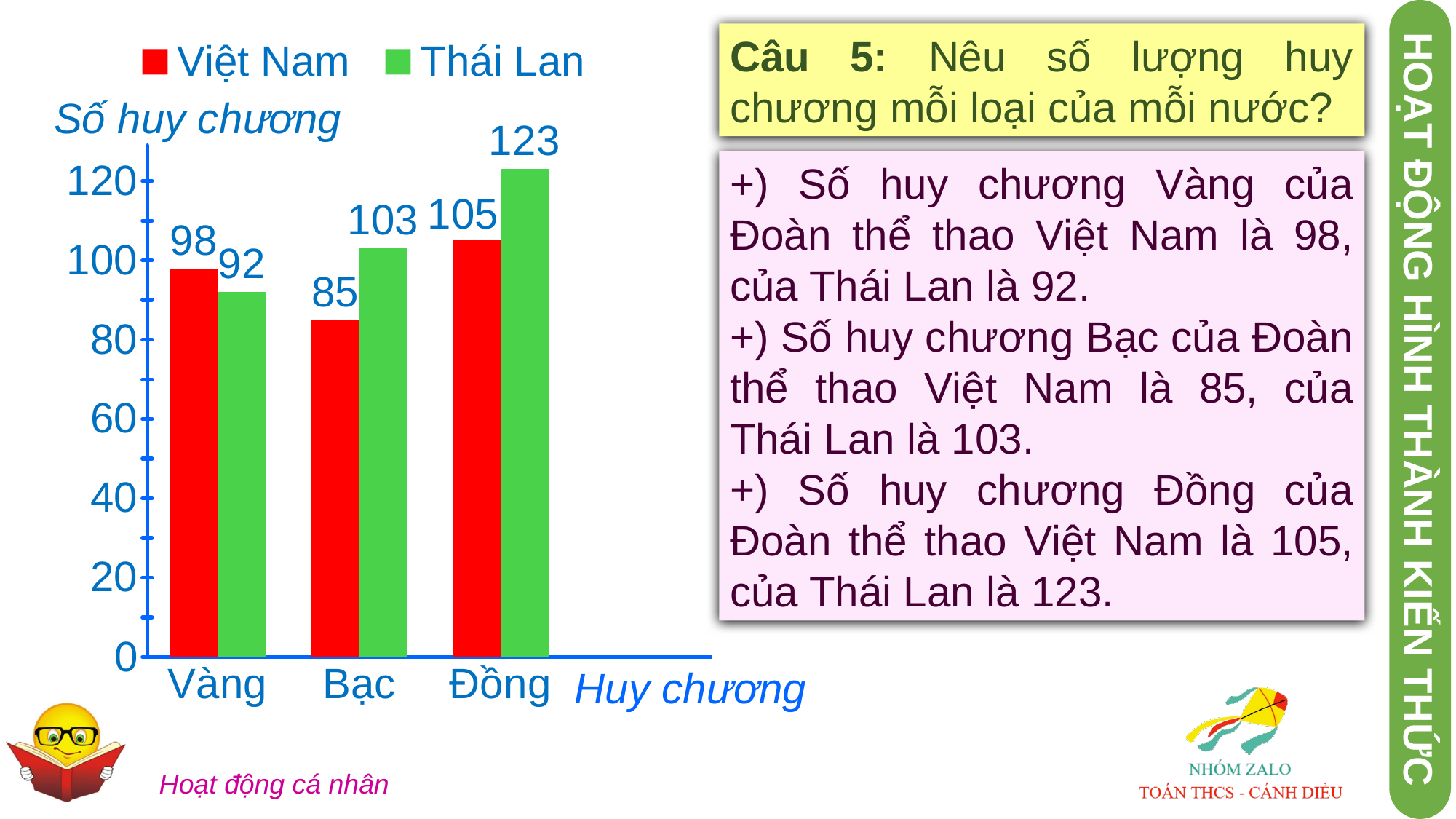
Which category has the lowest value for Thái Lan? Vàng What is the label of the vertical axis? Số huy chương How many categories are shown on the x axis? 3 What is the value for Thái Lan in the Bạc category? 103 What is the difference between Thái Lan and Việt Nam in the Bạc category? 18 Which category has the highest value for Việt Nam? Đồng Which is larger in the Vàng category, Việt Nam or Thái Lan? Việt Nam How many series does the legend list? 2 What is the value for Việt Nam in the Vàng category? 98 What is the value for Thái Lan in the Đồng category? 123 What kind of chart is shown on the slide? bar chart Is the value for Thái Lan in the Đồng category greater or less than 120? greater